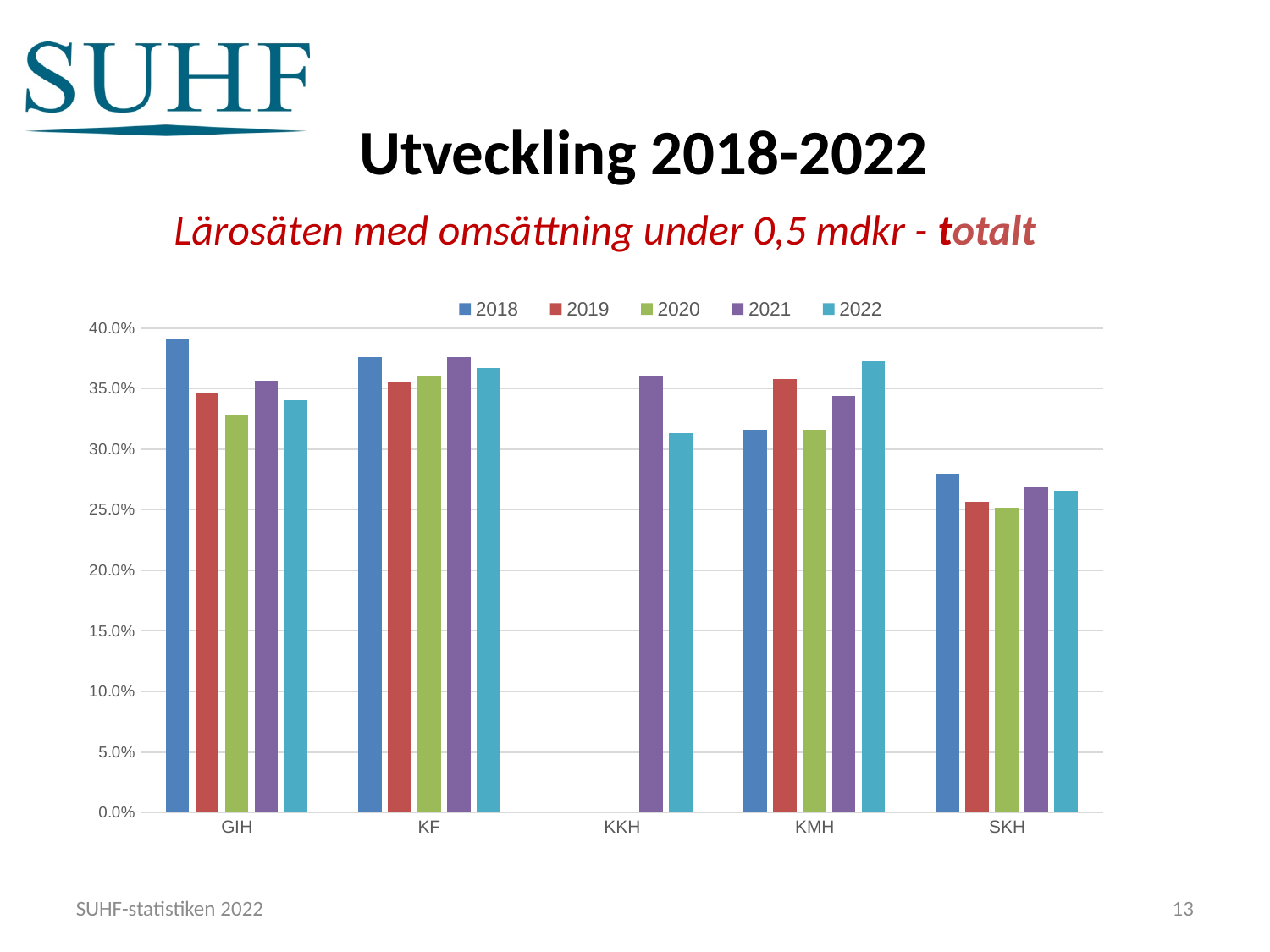
Is the value for GIH in 2018 greater or less than 35.0%? greater Which category has the highest value for 2018? GIH Is the value for SKH in 2018 greater or less than 25.0%? greater How many series does the legend list? 5 Is the value for GIH in 2020 greater or less than 35.0%? less Which is larger for KMH: the 2018 value or the 2019 value? 2019 How many categories are shown on the x axis? 5 Which category has bars only for 2021 and 2022? KKH Which category has the lowest value for 2022? SKH Which is larger for GIH: the 2018 value or the 2019 value? 2018 What kind of chart is shown on the slide? bar chart